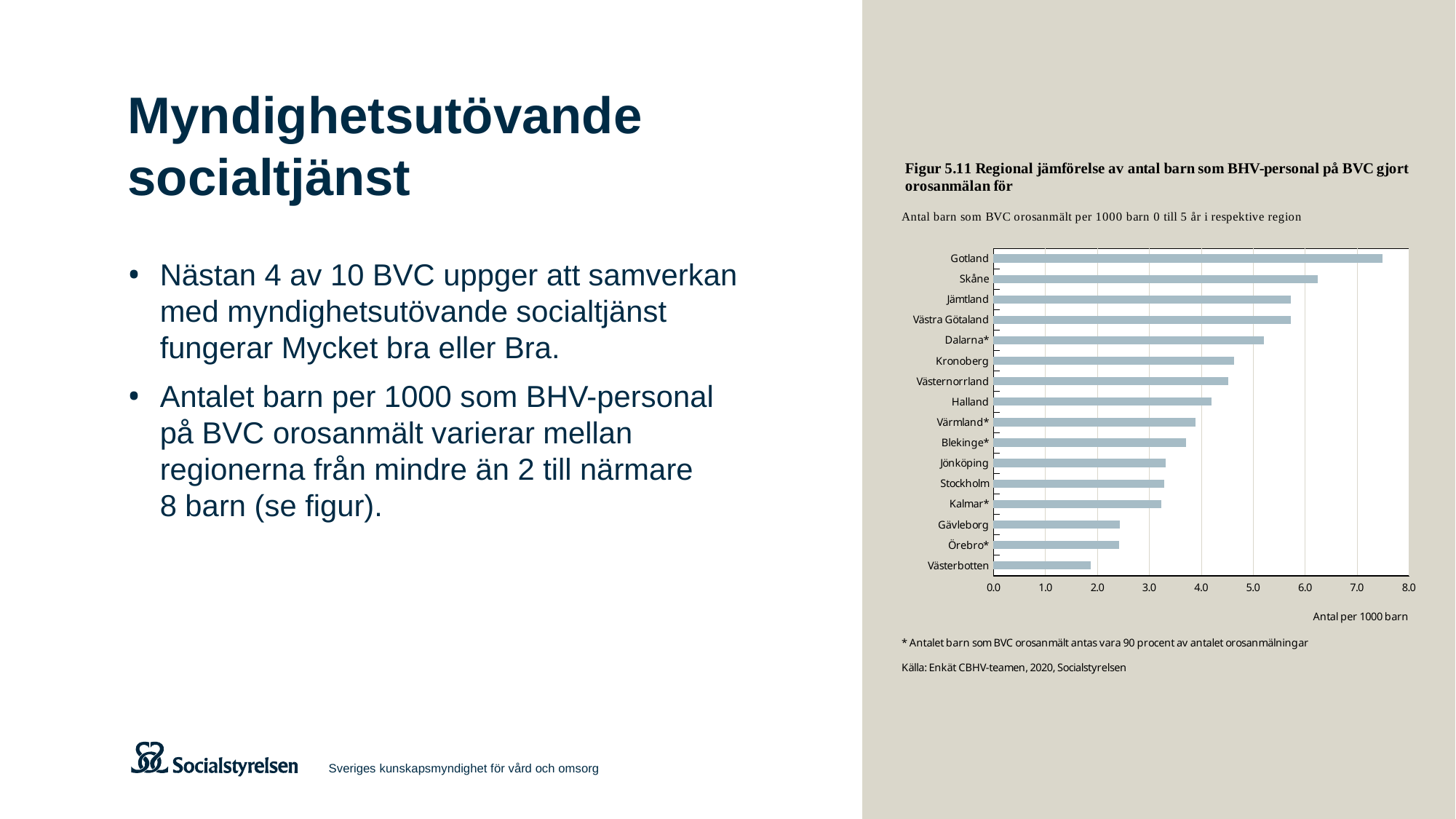
Is the value for Skåne greater or less than 6.0? greater Which has a higher value, Kronoberg or Gävleborg? Kronoberg What is the figure number given in the chart title? Figur 5.11 Which region has the lowest number of children per 1000 reported by BVC? Västerbotten What kind of chart is shown on the slide? bar chart Which has a higher value, Dalarna* or Blekinge*? Dalarna* Is the value for Gotland greater or less than 7.0? greater What is the label of the horizontal axis of the chart? Antal per 1000 barn How many regions are plotted in the chart? 16 Which region has the highest number of children per 1000 reported by BVC? Gotland Is the value for Halland greater or less than 5.0? less